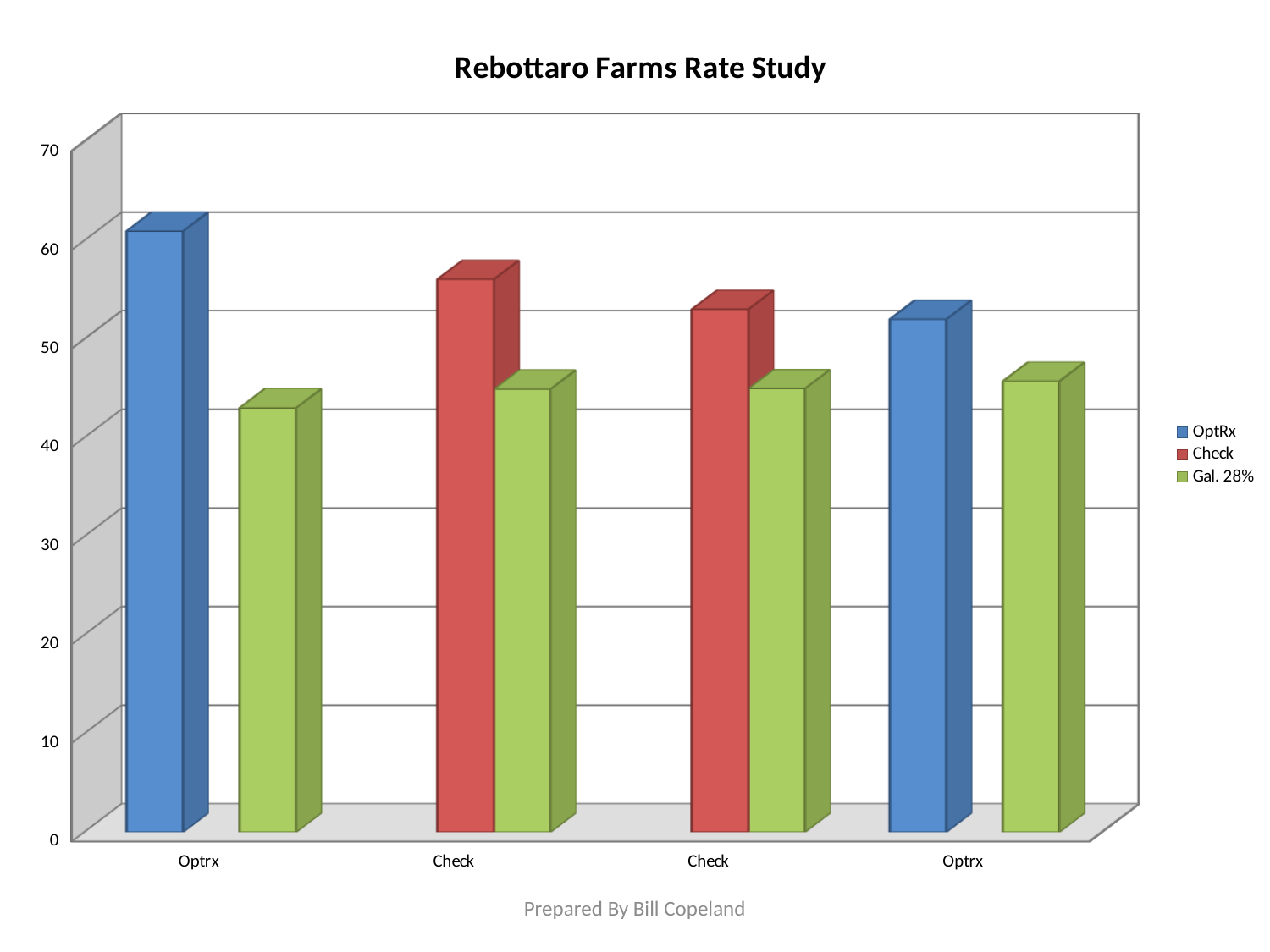
How many series does the legend list? 3 In the first Optrx category, which is larger, the OptRx bar or the Gal. 28% bar? OptRx Is the OptRx value for the last Optrx category greater or less than 60? less Which is larger, the OptRx bar in the first Optrx category or the OptRx bar in the last Optrx category? the first Optrx category Is the OptRx value for the first Optrx category greater or less than 60? greater What type of chart is shown on the slide? bar chart Which series is shown in green in the legend? Gal. 28% How many categories are shown along the x axis? 4 Is the Gal. 28% value for the first Optrx category greater or less than 50? less Which bar is the tallest in the chart? OptRx for the first Optrx category What is the title of the chart? Rebottaro Farms Rate Study